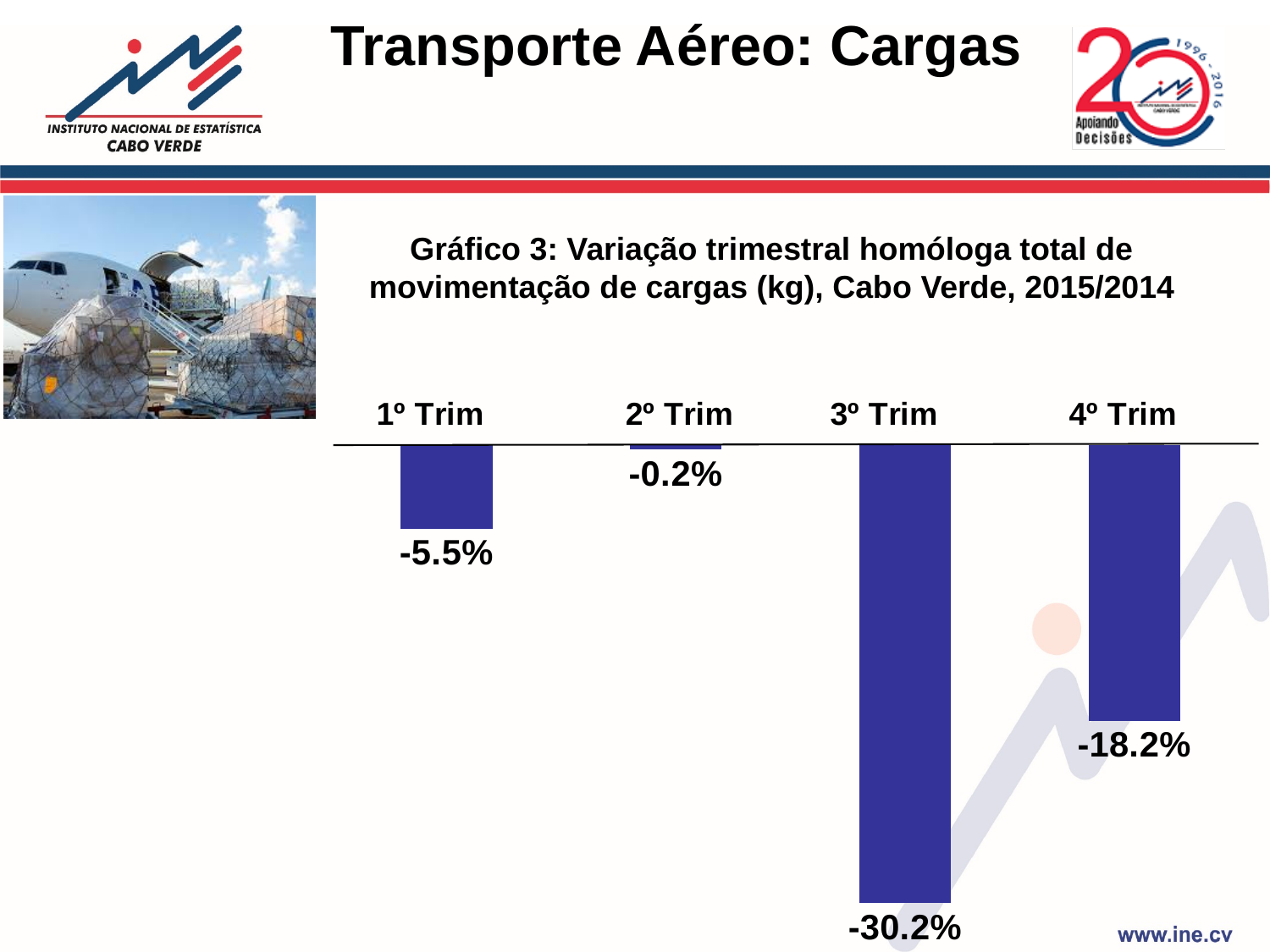
What is the value for 3º Trim? -30.2% What is the value for 4º Trim? -18.2% What is the value for 1º Trim? -5.5% Which is larger, the value for 1º Trim or the value for 4º Trim? 1º Trim What is the value for 2º Trim? -0.2% Which quarter has the lowest value? 3º Trim How many quarters are shown in the chart? 4 What is the difference between the values for 3º Trim and 4º Trim? 12 percentage points What kind of chart is shown on the slide? Bar chart What is the difference between the values for 1º Trim and 2º Trim? 5.3 percentage points Which quarter has the highest value? 2º Trim What is the title of the chart? Gráfico 3: Variação trimestral homóloga total de movimentação de cargas (kg), Cabo Verde, 2015/2014